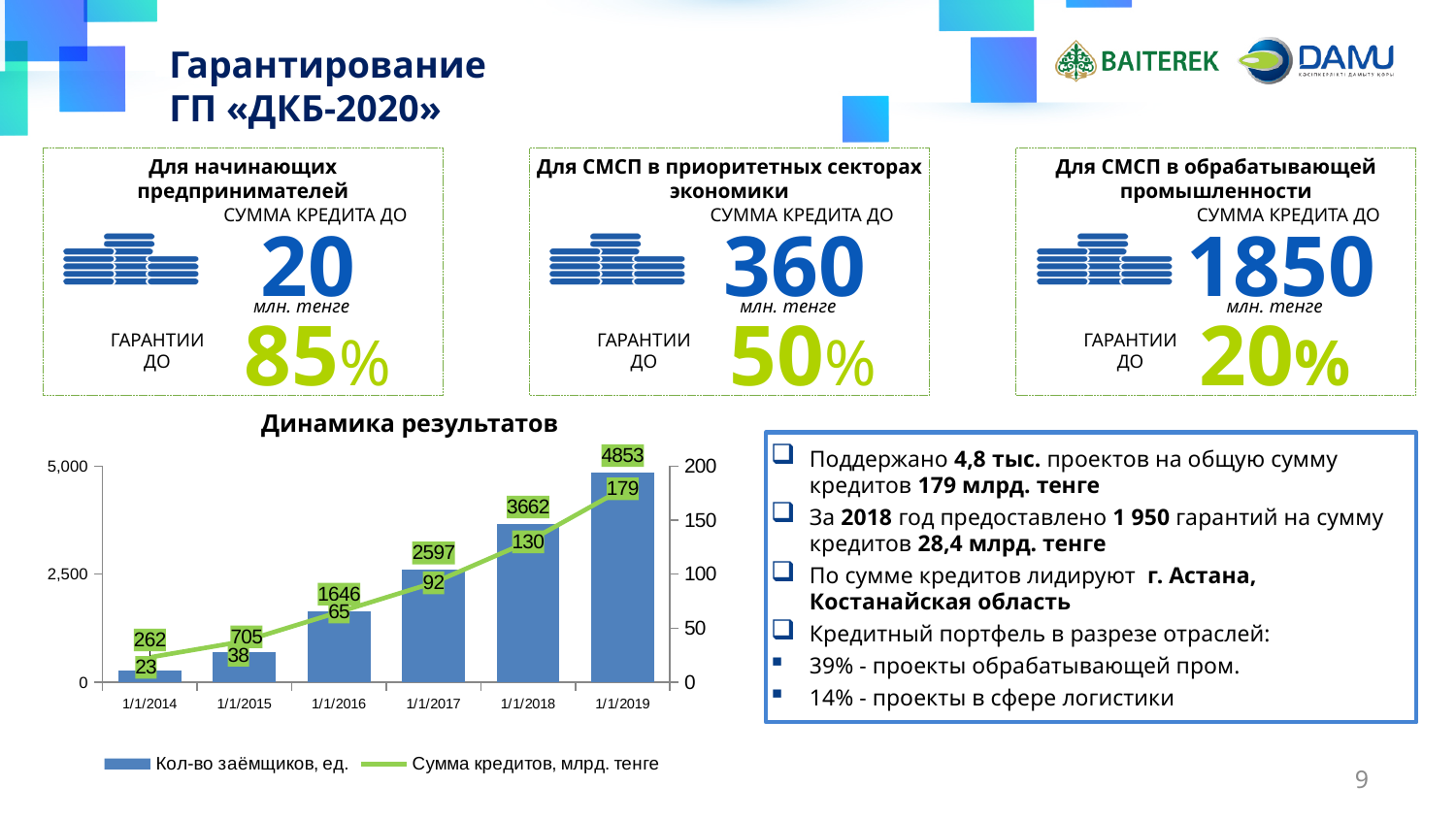
Which date has the highest value for Сумма кредитов, млрд. тенге? 1/1/2019 What is the difference in the number of borrowers between 1/1/2019 and 1/1/2018? 1191 Does the value of Сумма кредитов, млрд. тенге rise or fall from 1/1/2014 to 1/1/2019? rise How many dates are shown on the x axis of the chart? 6 Which is larger: the number of borrowers for 1/1/2015 or for 1/1/2016? 1/1/2016 How many series does the chart legend list? 2 What is the number of borrowers (Кол-во заёмщиков, ед.) shown for 1/1/2019? 4853 What kind of chart is used to show the number of borrowers (Кол-во заёмщиков, ед.)? bar chart Which date has the lowest number of borrowers (Кол-во заёмщиков, ед.)? 1/1/2014 What is the difference in Сумма кредитов, млрд. тенге between 1/1/2018 and 1/1/2017? 38 What is the value of Сумма кредитов, млрд. тенге for 1/1/2016? 65 What is the number of borrowers (Кол-во заёмщиков, ед.) for 1/1/2014? 262